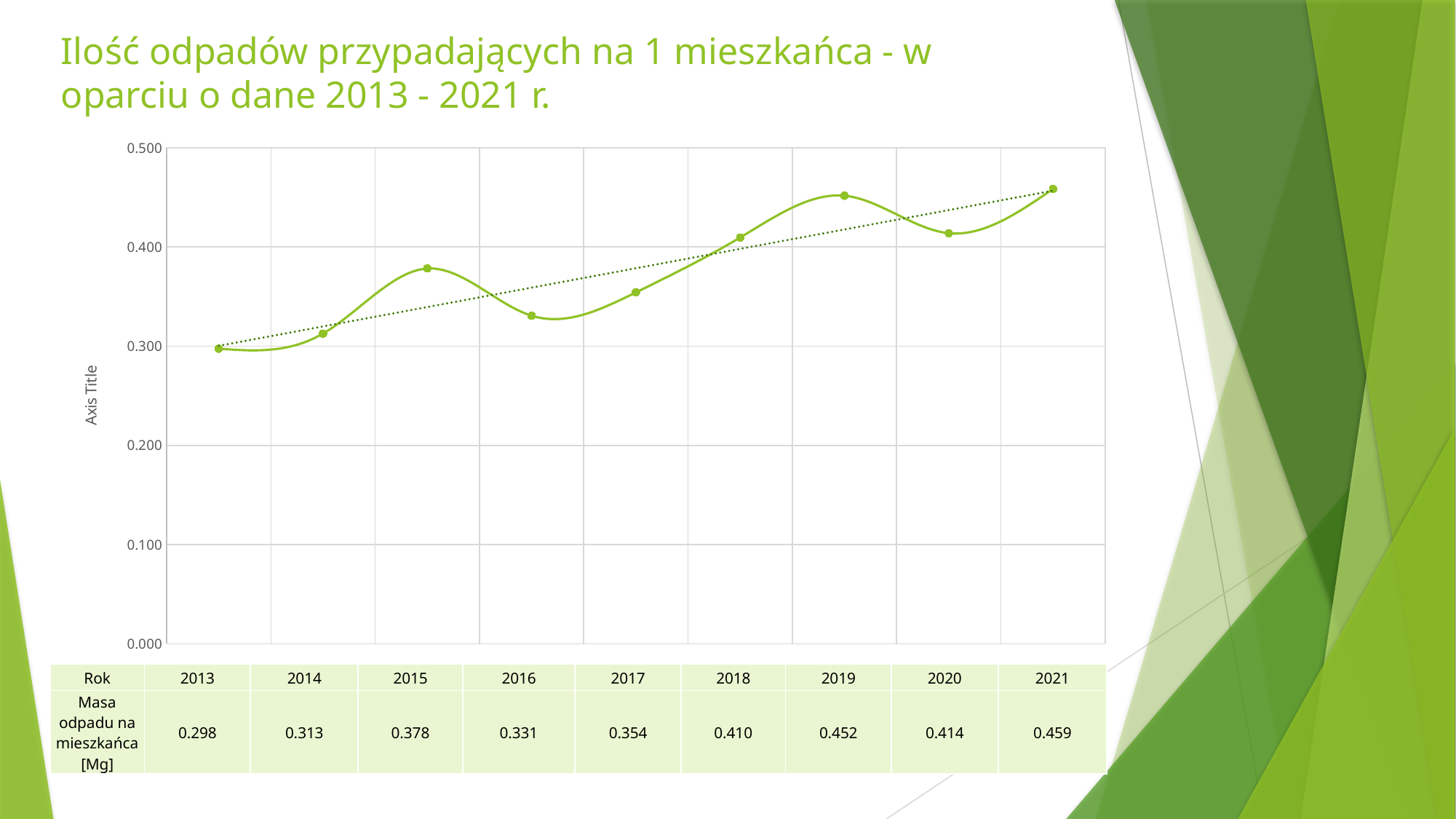
What is the value for 2015 in the chart? 0.378 Which is larger, the value for 2016 or the value for 2017? 2017 Is the value for 2018 greater or less than 0.400? greater What is the value for 2020 in the chart? 0.414 Which year has the highest value in the chart? 2021 Do the values generally rise or fall from 2013 to 2021? rise What kind of chart is shown on the slide? line chart Which year has the lowest value in the chart? 2013 What is the difference between the values for 2019 and 2018? 0.042 How many years are plotted in the chart? 9 What is the difference between the values for 2021 and 2013? 0.161 What is the label shown on the vertical axis of the chart? Axis Title